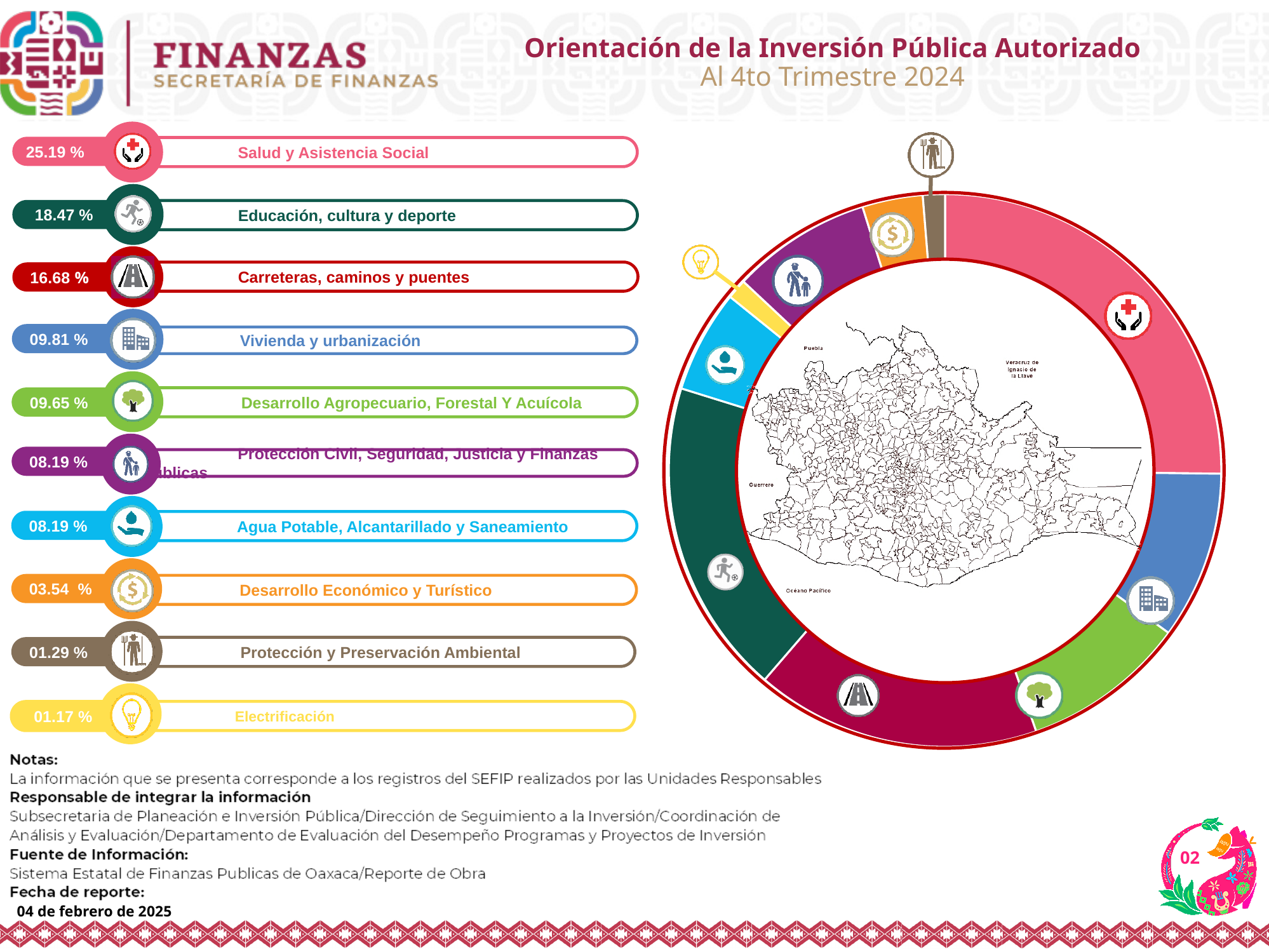
What share of the authorized public investment goes to Salud y Asistencia Social? 25.19 % Which category has the smallest share of the authorized public investment? Electrificación Which category has the largest share of the authorized public investment? Salud y Asistencia Social What percentage is shown for Agua Potable, Alcantarillado y Saneamiento? 08.19 % What is the combined share of the three largest categories (Salud y Asistencia Social, Educación, cultura y deporte, and Carreteras, caminos y puentes)? 60.34 % What percentage is shown for Carreteras, caminos y puentes? 16.68 % What is the title of the chart on the slide? Orientación de la Inversión Pública Autorizado Al 4to Trimestre 2024 Which has a larger share: Vivienda y urbanización or Desarrollo Agropecuario, Forestal Y Acuícola? Vivienda y urbanización What percentage is shown for Electrificación? 01.17 % What kind of chart is shown on the slide? Pie (donut) chart What is the difference in percentage points between Salud y Asistencia Social and Educación, cultura y deporte? 6.72 % How many categories are shown in the chart? 10